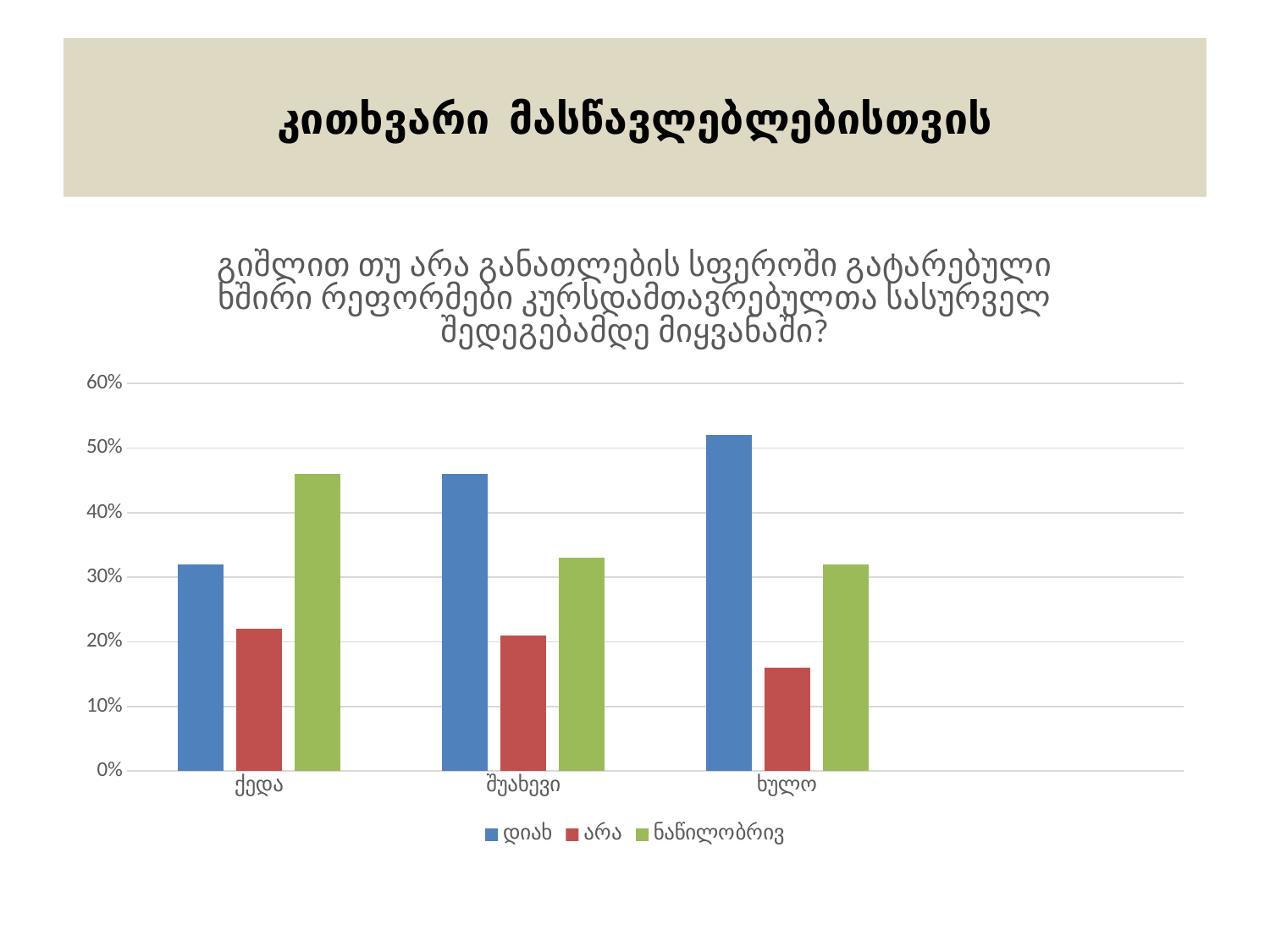
Is the value for ნაწილობრივ in ქედა greater or less than 40%? greater How many series does the legend list? 3 Which category has the highest value for the ნაწილობრივ series? ქედა Which series is shown in green in the chart? ნაწილობრივ Do the values for the დიახ series rise or fall from ქედა to ხულო? rise Is the value for არა in ხულო greater or less than 20%? less Which category has the highest value for the დიახ series? ხულო In ქედა, which is larger: the value for დიახ or the value for ნაწილობრივ? ნაწილობრივ What kind of chart is shown on the slide? bar chart Is the value for დიახ in ხულო greater or less than 40%? greater How many categories are shown on the x axis of the chart? 3 Which category has the lowest value for the არა series? ხულო